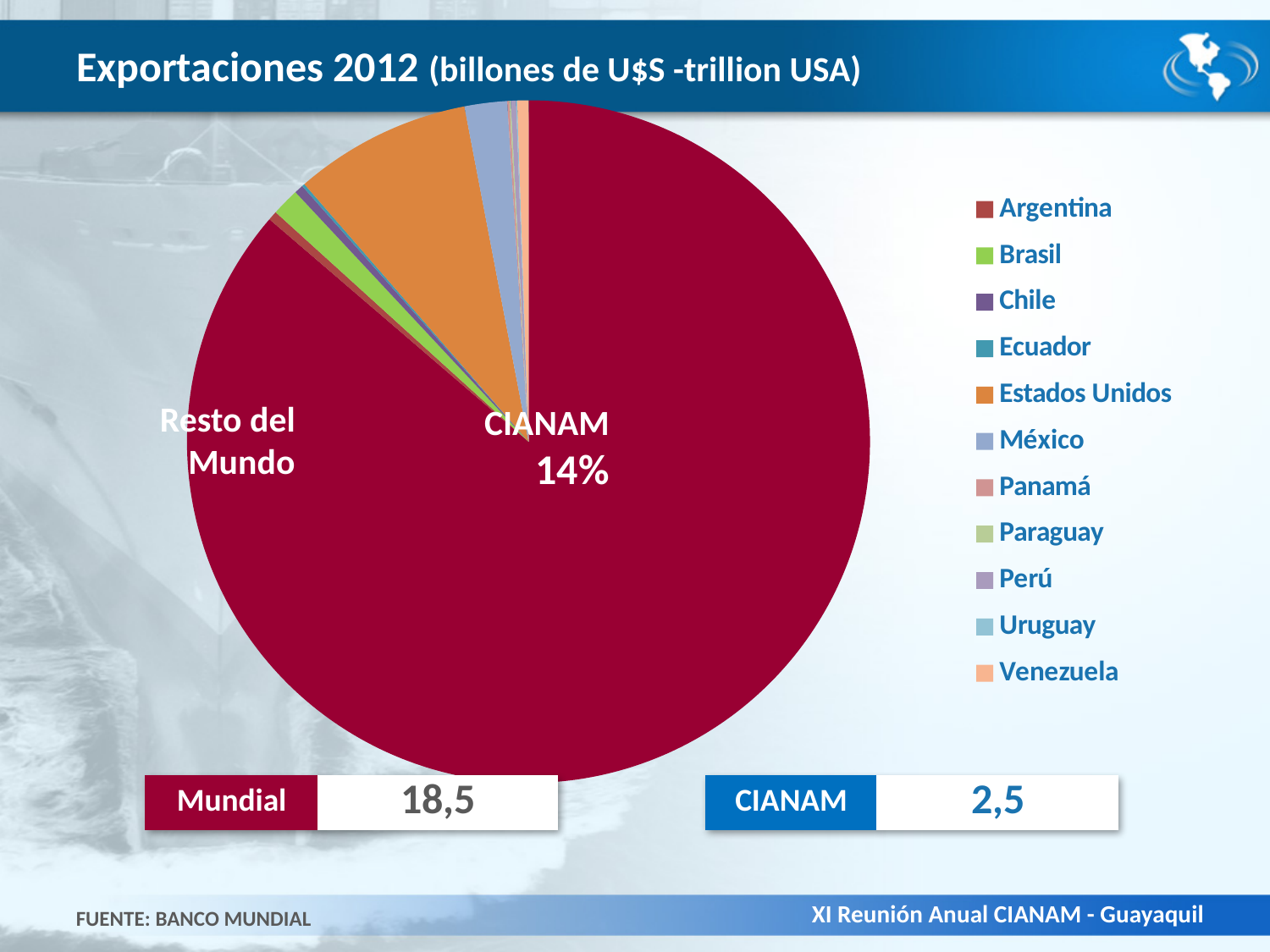
What is the difference between the Mundial value and the CIANAM value? 16 What share of the pie does CIANAM represent? 14% What is the value shown for Mundial? 18,5 Which slice of the pie is the largest? Resto del Mundo How many countries are listed in the legend of the pie chart? 11 Among the CIANAM countries in the legend, which one has the largest slice of the pie? Estados Unidos What source is cited for the chart data? BANCO MUNDIAL What is the value shown for CIANAM? 2,5 What kind of chart is shown on the slide? pie chart What is the title of the chart? Exportaciones 2012 (billones de U$S -trillion USA) Which slice is larger, Estados Unidos or Brasil? Estados Unidos Which is larger, the Mundial value or the CIANAM value? Mundial